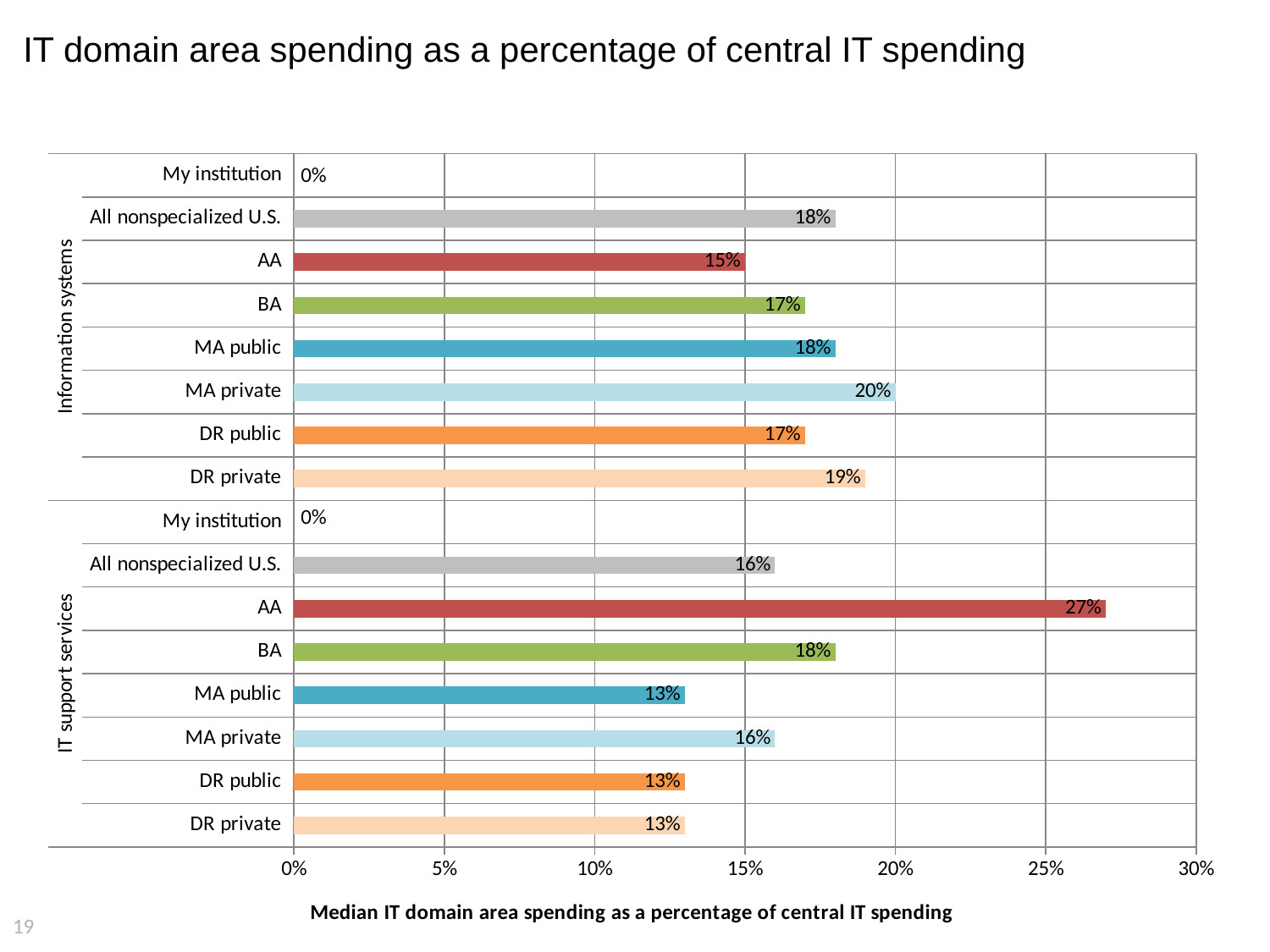
Which category has the lowest non-zero value in the Information systems group? AA What is the value for All nonspecialized U.S. in the Information systems group? 18% What kind of chart is shown on the slide? Bar chart Which is larger in the IT support services group: BA or MA private? BA What is the difference between AA in IT support services and AA in Information systems? 12% What is the difference between MA private and MA public in the Information systems group? 2% What is the value for DR private in the IT support services group? 13% Which category has the highest value in the IT support services group? AA Is the value for AA in the IT support services group greater or less than 25%? greater What is the x-axis title of the chart? Median IT domain area spending as a percentage of central IT spending What is the value for MA private in the Information systems group? 20% What is the value for AA in the IT support services group? 27%